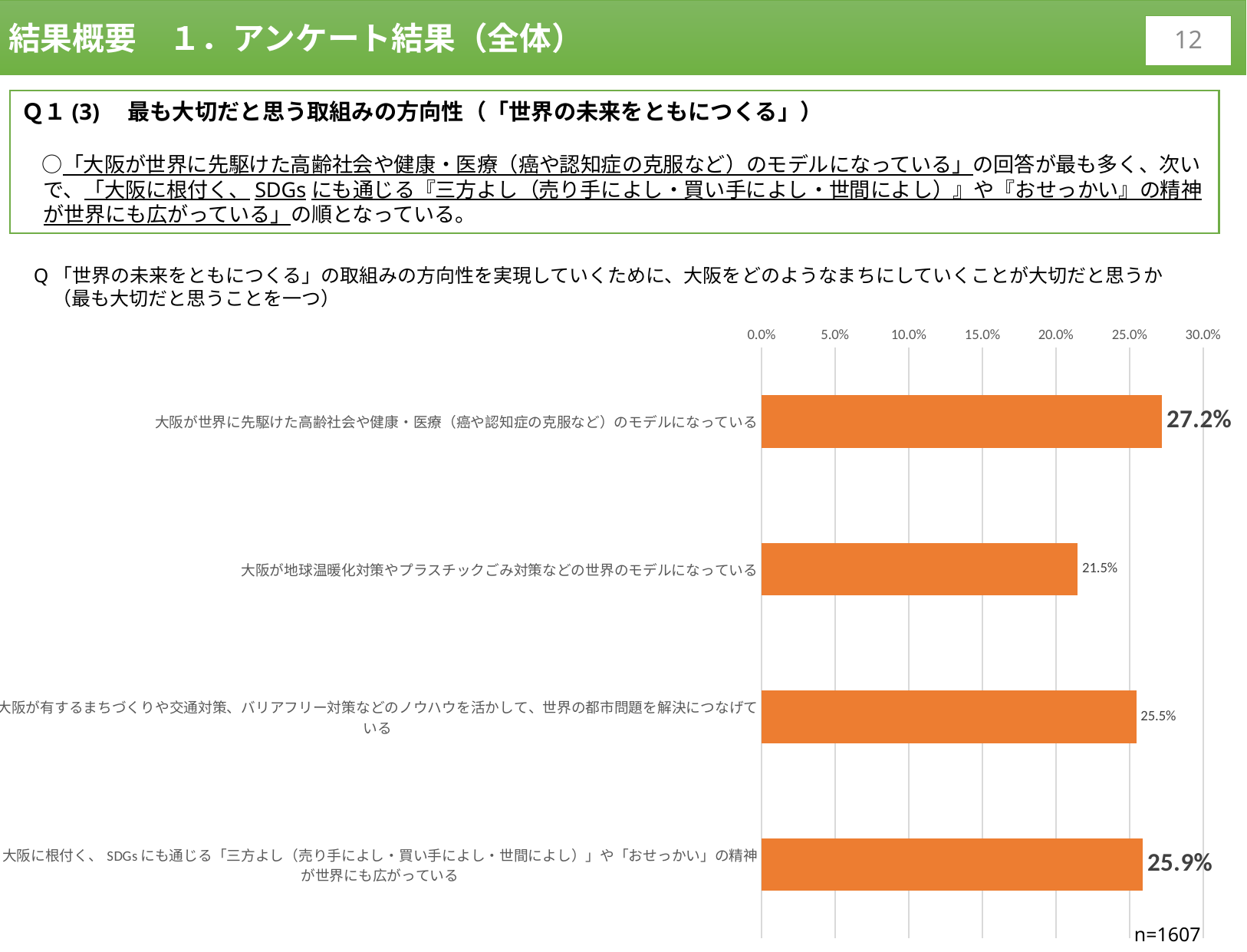
What is the value shown for 「大阪が地球温暖化対策やプラスチックごみ対策などの世界のモデルになっている」? 21.5% Which category has the lowest percentage in the chart? 大阪が地球温暖化対策やプラスチックごみ対策などの世界のモデルになっている Is the value for 「大阪が地球温暖化対策やプラスチックごみ対策などの世界のモデルになっている」 greater or less than 25.0%? less What is the difference in percentage points between the highest bar (27.2%) and the lowest bar (21.5%)? 5.7 Which is larger: the value for the 三方よし・おせっかい category or the value for the 地球温暖化対策・プラスチックごみ対策 category? 三方よし・おせっかい category (25.9%) What percentage is shown for the bar about 大阪が有するまちづくりや交通対策、バリアフリー対策などのノウハウを活かして、世界の都市問題を解決につなげている? 25.5% What is the sample size (n) noted on the chart? n=1607 What is the value for 「大阪に根付く、SDGsにも通じる『三方よし』や『おせっかい』の精神が世界にも広がっている」? 25.9% Which category has the highest percentage in the chart? 大阪が世界に先駆けた高齢社会や健康・医療（癌や認知症の克服など）のモデルになっている What percentage of respondents chose 「大阪が世界に先駆けた高齢社会や健康・医療（癌や認知症の克服など）のモデルになっている」? 27.2% What type of chart is shown on the slide? Bar chart How many categories (bars) are shown in the chart? 4